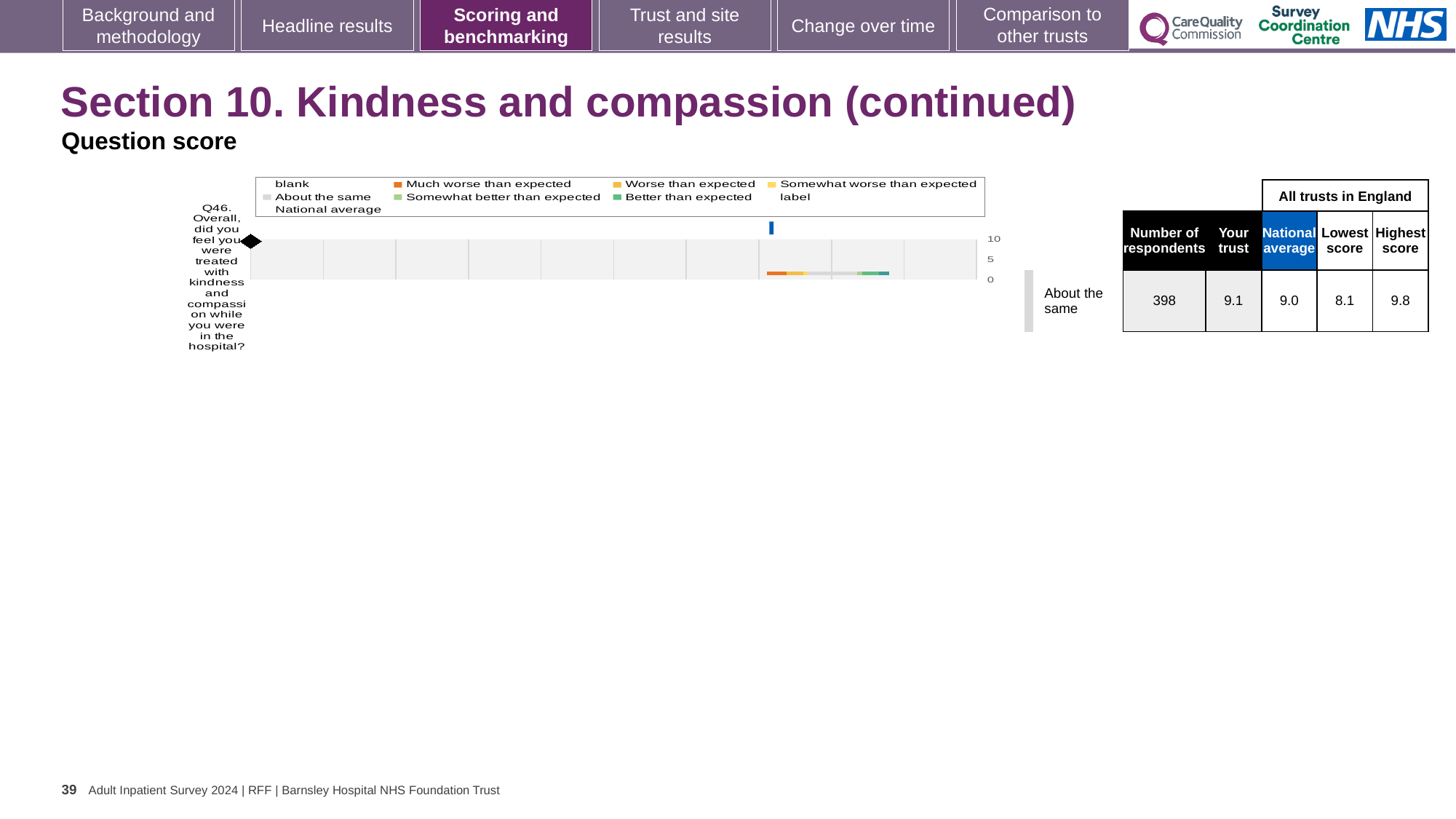
What is the 'Your trust' score for Q46 shown in the table next to the chart? 9.1 What kind of chart is used to show the Q46 question score? bar chart What is the lowest score among all trusts in England for Q46? 8.1 How many survey questions are plotted on the chart? 1 What is the national average score for Q46? 9.0 What is the highest score among all trusts in England for Q46? 9.8 Which benchmarking category is the trust's Q46 result placed in? About the same Which question number is plotted on the chart? Q46 What is the highest value shown on the chart's score axis? 10 What is the difference between the highest score and the lowest score for Q46? 1.7 How many respondents answered Q46? 398 Which is larger for Q46, the 'Your trust' score or the national average? Your trust